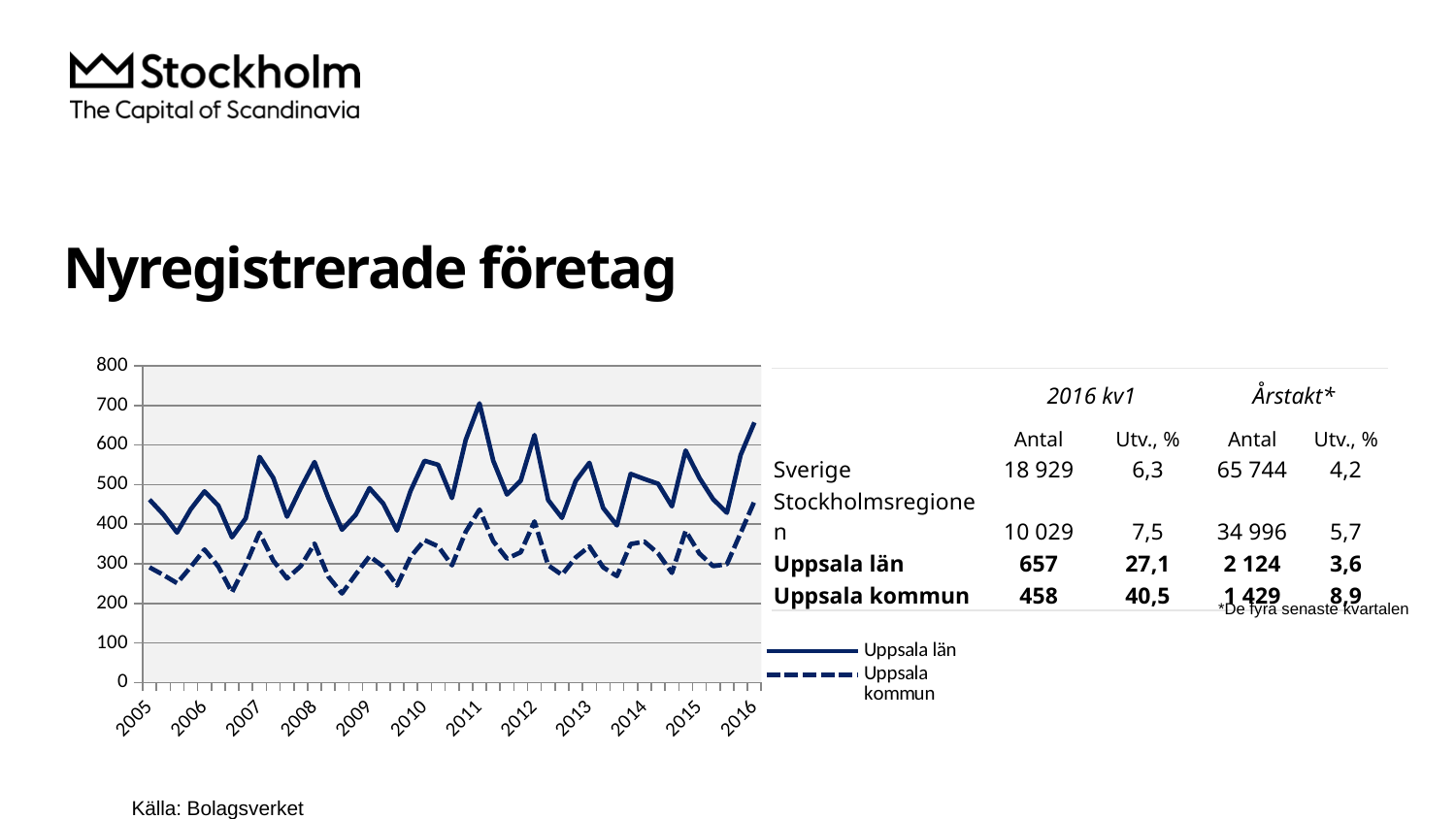
What kind of chart is shown on the slide? line chart Which two series are shown in the chart legend? Uppsala län and Uppsala kommun What is the maximum value shown on the chart's y axis? 800 Is the highest value of the Uppsala län series greater or less than 600? greater How many series does the chart legend list? 2 Is the last plotted value for Uppsala län in 2016 greater or less than 600? greater How many years are labelled on the x axis of the chart? 12 Is the last plotted value for Uppsala kommun in 2016 greater or less than 400? greater Which series is drawn with a dashed line? Uppsala kommun In which year does the Uppsala län series reach its highest peak? 2011 Which series has consistently higher values across the chart, Uppsala län or Uppsala kommun? Uppsala län